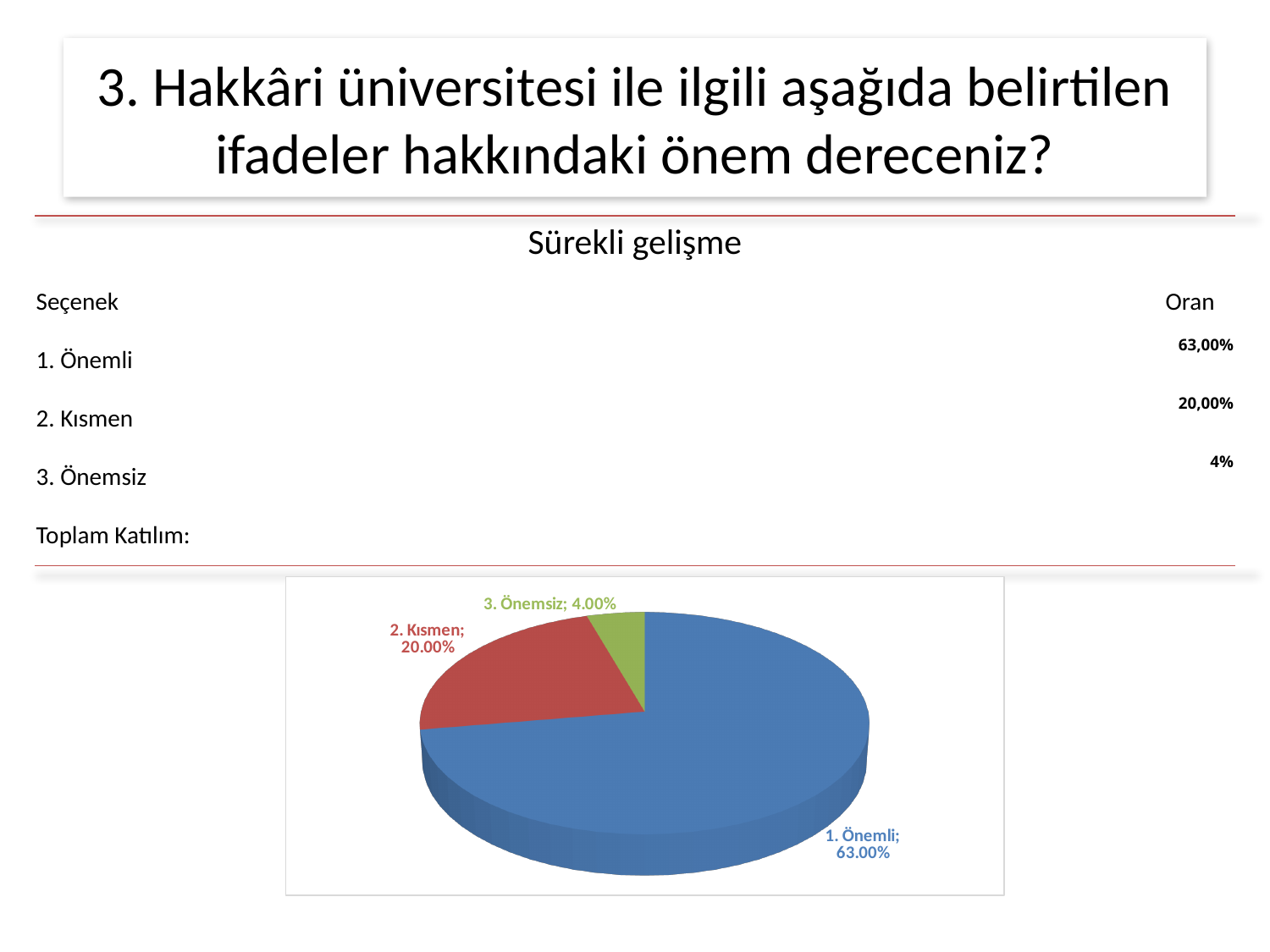
What colour is the slice for 2. Kısmen in the pie chart? red What is the value shown for the slice labelled 2. Kısmen? 20.00% What is the difference between the values for 1. Önemli and 2. Kısmen? 43.00% What is the value shown for the slice labelled 1. Önemli? 63.00% What kind of chart is shown on the slide? pie chart How many slices does the pie chart have? 3 What is the value shown for the slice labelled 3. Önemsiz? 4.00% Which slice of the pie chart is the largest? 1. Önemli Which is larger, the slice for 2. Kısmen or the slice for 3. Önemsiz? 2. Kısmen Which slice of the pie chart is the smallest? 3. Önemsiz What is the difference between the values for 2. Kısmen and 3. Önemsiz? 16.00% What colour is the slice for 1. Önemli in the pie chart? blue